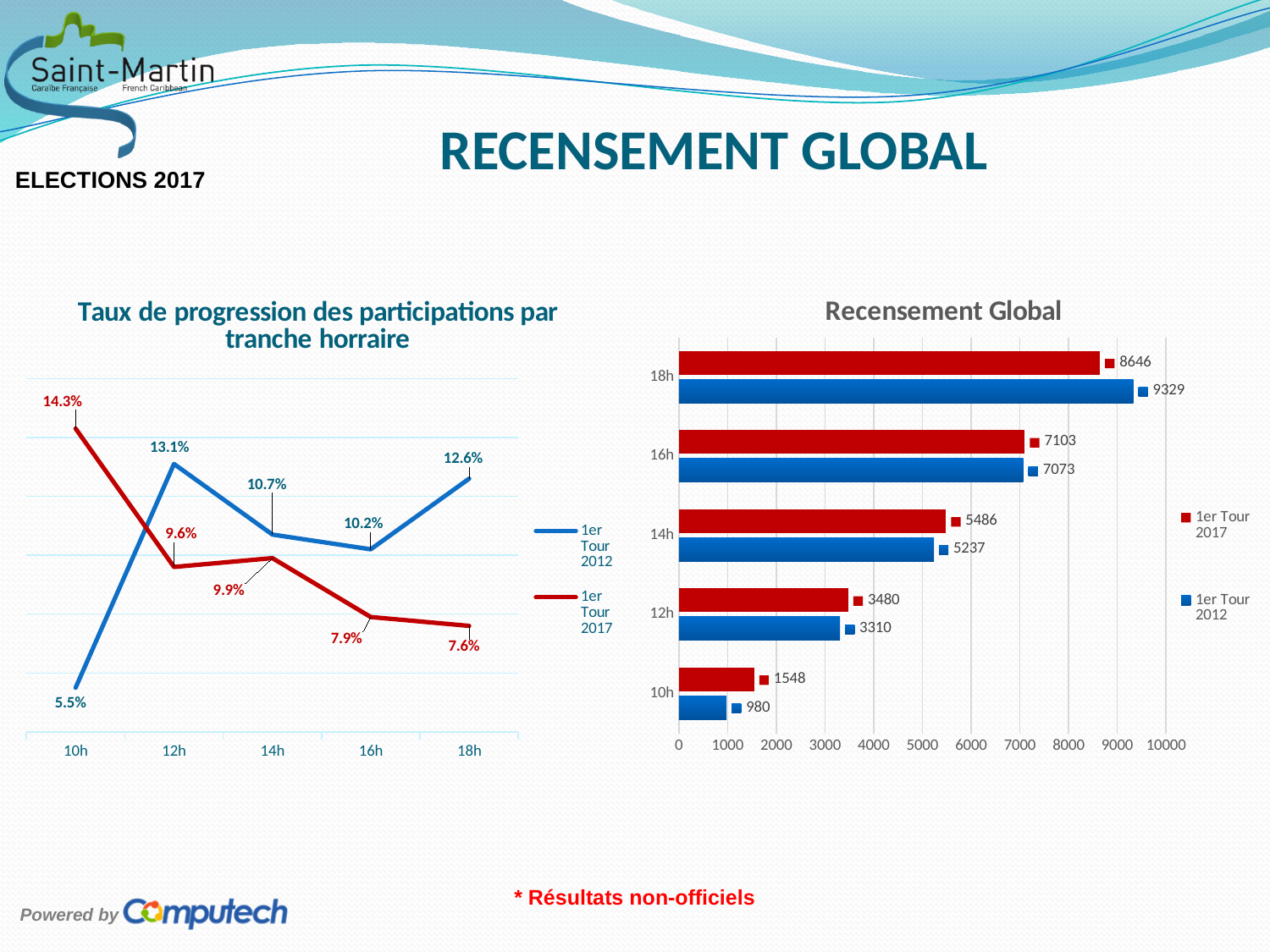
In the 'Taux de progression des participations par tranche horaire' chart, what is the value for 1er Tour 2012 at 12h? 13.1% In the 'Taux de progression des participations par tranche horaire' chart, how many time slots are shown on the x axis? 5 In the 'Taux de progression des participations par tranche horaire' chart, which time slot has the lowest value for 1er Tour 2012? 10h In the 'Recensement Global' chart, which time slot has the lowest value for 1er Tour 2012? 10h What kind of chart is 'Recensement Global'? bar chart In the 'Recensement Global' chart, what is the difference between 1er Tour 2017 and 1er Tour 2012 at 12h? 170 How many series does the legend of the 'Recensement Global' chart list? 2 In the 'Taux de progression des participations par tranche horaire' chart, what is the value for 1er Tour 2017 at 10h? 14.3% In the 'Taux de progression des participations par tranche horaire' chart, does the 1er Tour 2017 series rise or fall from 14h to 18h? fall In the 'Recensement Global' chart, what is the value for 1er Tour 2017 at 10h? 1548 In the 'Recensement Global' chart, what is the value for 1er Tour 2012 at 18h? 9329 In the 'Recensement Global' chart, which is larger at 14h: 1er Tour 2017 or 1er Tour 2012? 1er Tour 2017